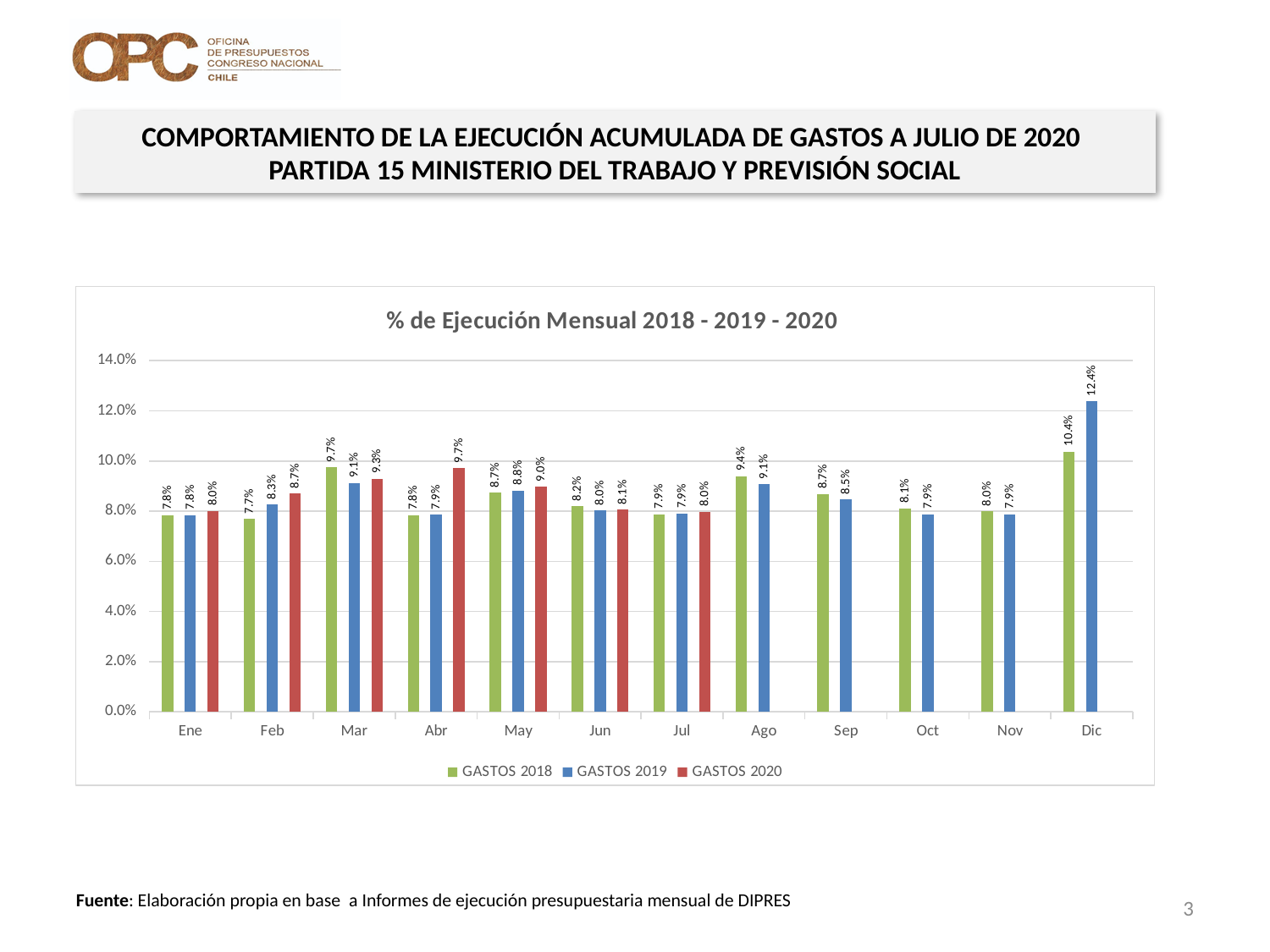
What is the value for GASTOS 2018 in Mar? 9.7% How many months are shown on the x axis? 12 Which is larger in Feb: GASTOS 2019 or GASTOS 2018? GASTOS 2019 Which month has the lowest value for GASTOS 2018? Feb What is the value for GASTOS 2020 in Abr? 9.7% How many series does the legend list? 3 What is the title of the chart? % de Ejecución Mensual 2018 - 2019 - 2020 What is the value for GASTOS 2019 in Dic? 12.4% What is the difference between GASTOS 2019 and GASTOS 2018 in Dic? 2.0% What kind of chart is shown on the slide? Bar chart Which month has the highest value for GASTOS 2018? Dic Which month has the highest value for GASTOS 2020? Abr